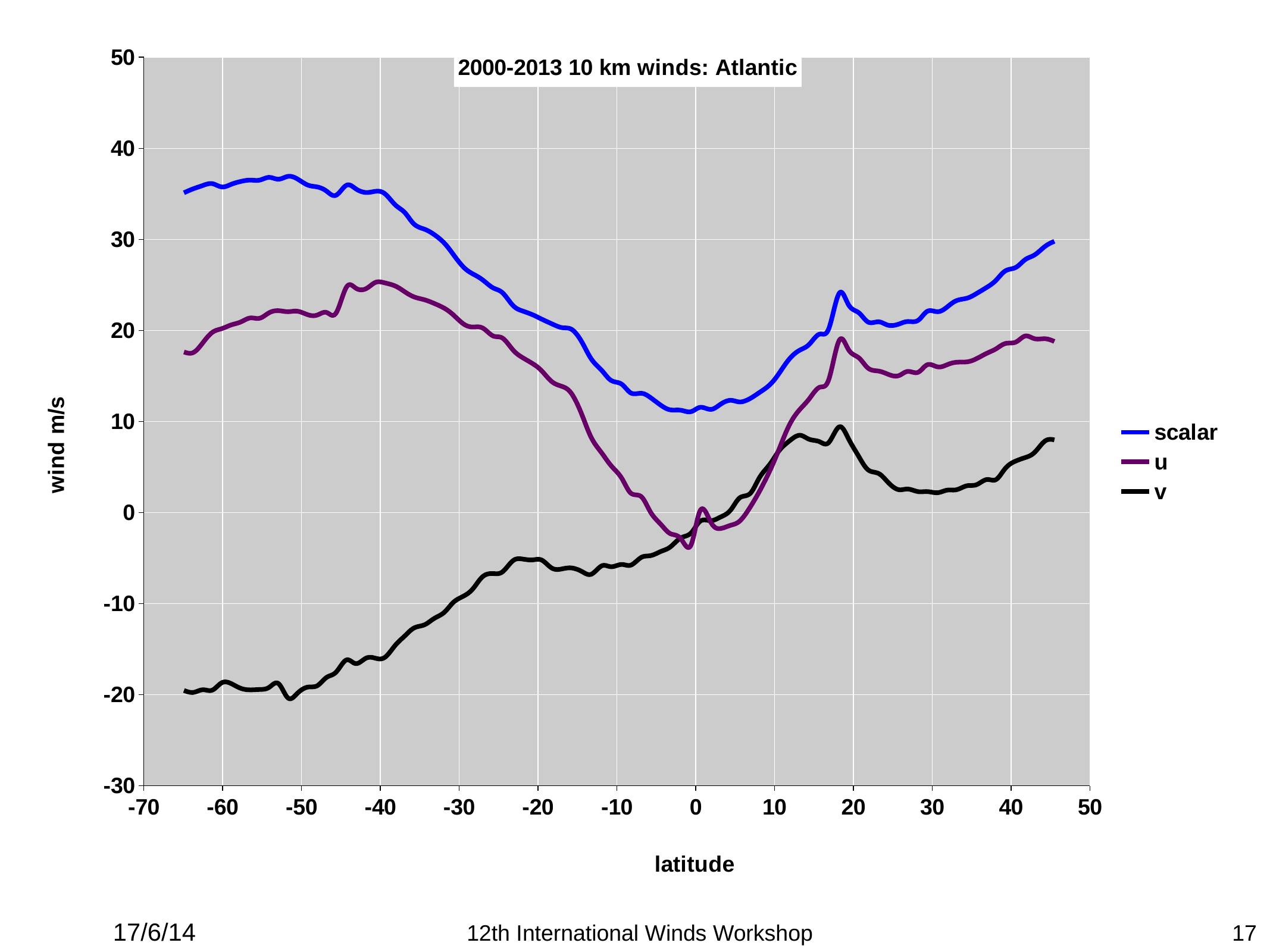
What is the title of the chart? 2000-2013 10 km winds: Atlantic At latitude 30, which series has the larger value, u or v? u Which series has the highest value at latitude -50? scalar Is the value of the v series at latitude -60 greater or less than -10? less Is the value of the v series at latitude 40 greater or less than 0? greater Is the value of the u series at latitude -40 greater or less than 20? greater What is the label on the vertical axis of the chart? wind m/s Does the scalar series rise or fall between latitude -50 and latitude 0? fall What kind of chart is shown on the slide? line chart How many series does the legend list? 3